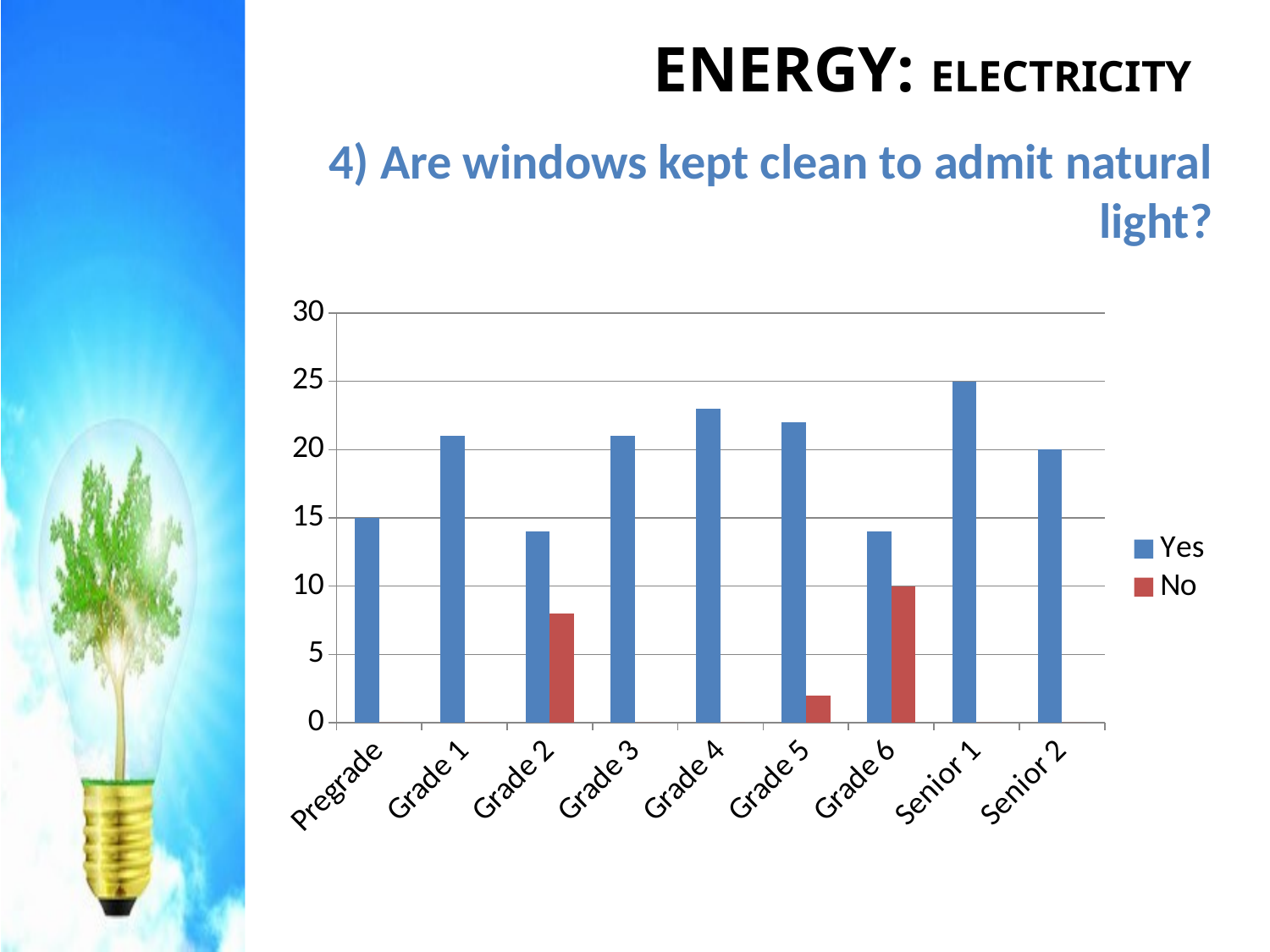
How many grade categories are shown on the x axis? 9 What is the Yes value for Pregrade? 15 What is the Yes value for Senior 2? 20 Which category has the highest No value? Grade 6 What is the Yes value for Senior 1? 25 Is the Yes value for Grade 4 greater or less than 20? greater What is the No value for Grade 6? 10 Which is larger, the No value for Grade 2 or the No value for Grade 5? Grade 2 Which category has the highest Yes value? Senior 1 Is the No value for Grade 5 greater or less than 5? less How many series does the legend list? 2 What type of chart is shown on the slide? bar chart